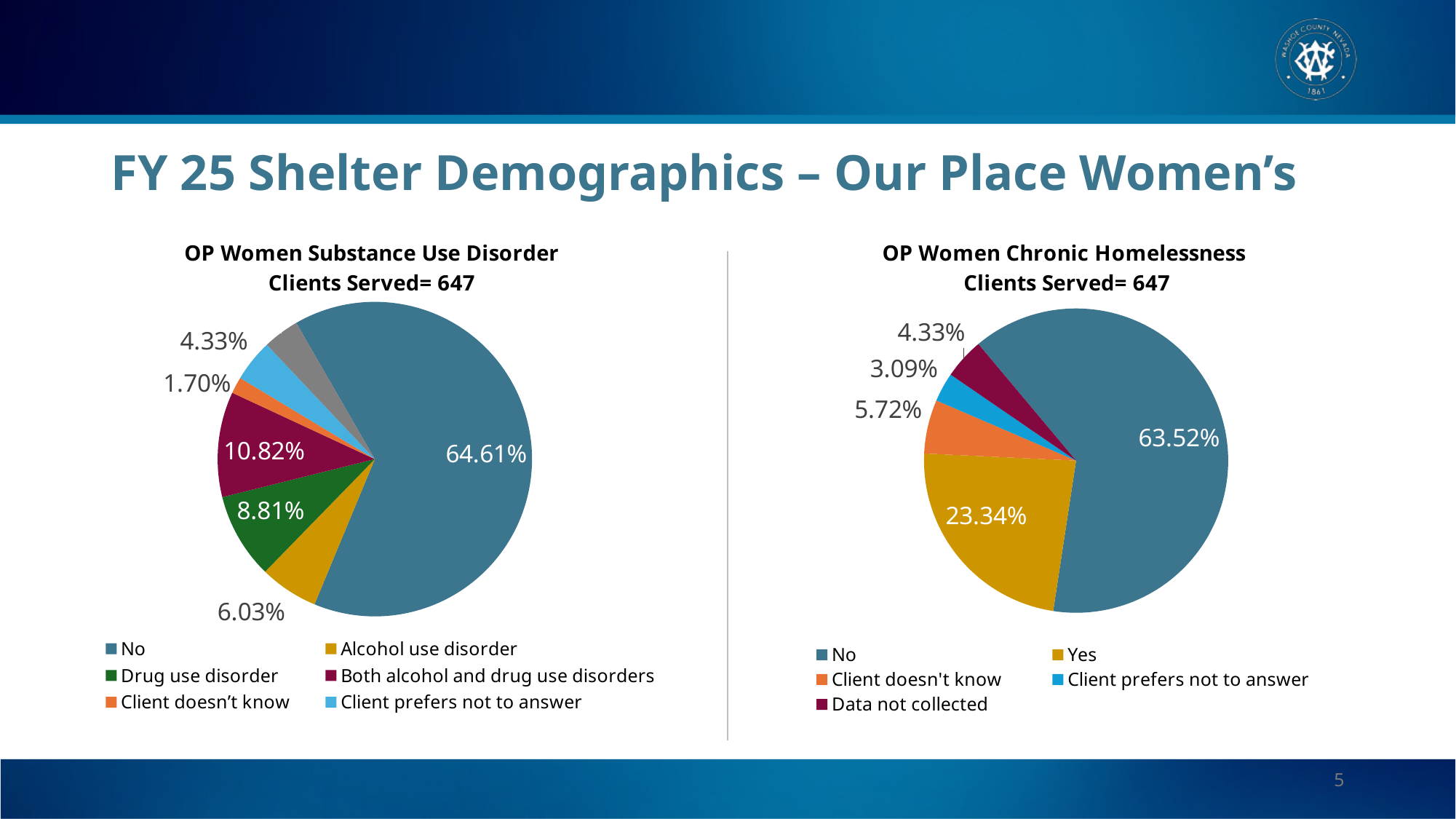
In the OP Women Chronic Homelessness chart, what is the difference between No and Yes? 40.18% In the OP Women Substance Use Disorder chart, what percentage of clients answered No? 64.61% In the OP Women Substance Use Disorder chart, what is the difference between Both alcohol and drug use disorders and Alcohol use disorder? 4.79% What type of chart is the OP Women Chronic Homelessness chart? Pie chart In the OP Women Substance Use Disorder chart, what percentage is Drug use disorder? 8.81% In the OP Women Substance Use Disorder chart, which category has the smallest labelled share? Client doesn't know In the OP Women Chronic Homelessness chart, what share is Client doesn't know? 5.72% In the OP Women Substance Use Disorder chart, which is larger: Alcohol use disorder or Drug use disorder? Drug use disorder In the OP Women Chronic Homelessness chart, what percentage of clients answered Yes? 23.34% In the OP Women Chronic Homelessness chart, which category has the largest share? No How many categories does the legend of the OP Women Chronic Homelessness chart list? 5 In the OP Women Substance Use Disorder chart, what share is Both alcohol and drug use disorders? 10.82%